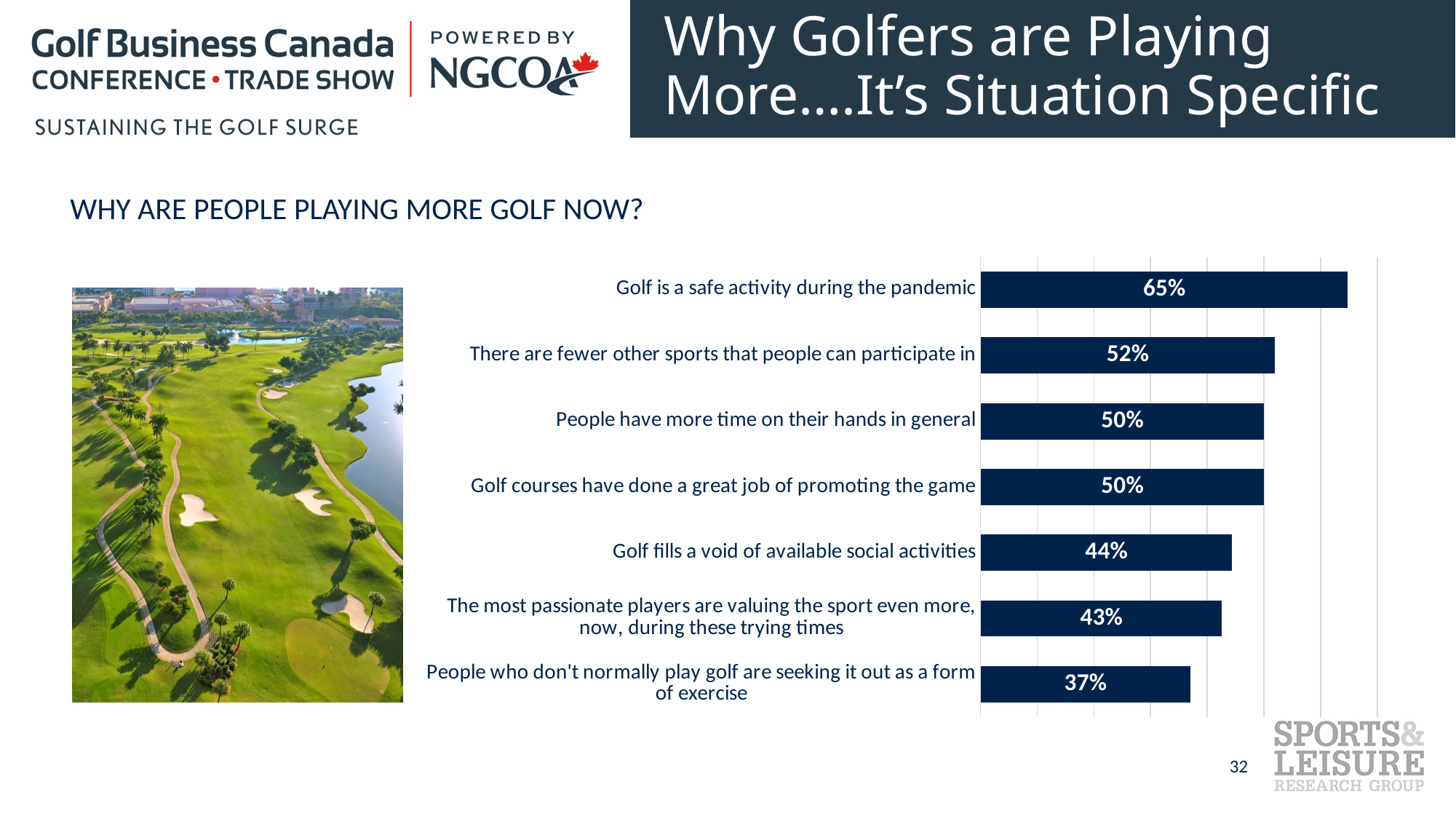
What is the value for 'There are fewer other sports that people can participate in'? 52% What is the difference between the highest and lowest percentages shown? 28% What type of chart is shown on the slide? Bar chart What percentage of respondents said golf is a safe activity during the pandemic? 65% Which reason has the lowest percentage? People who don't normally play golf are seeking it out as a form of exercise How many reasons are listed in the chart? 7 Which reason has the highest percentage? Golf is a safe activity during the pandemic What percentage is shown for 'Golf fills a void of available social activities'? 44% How much higher is 'Golf is a safe activity during the pandemic' than 'There are fewer other sports that people can participate in'? 13% What question does the chart heading ask? WHY ARE PEOPLE PLAYING MORE GOLF NOW? What is the value for 'People who don't normally play golf are seeking it out as a form of exercise'? 37% Which is larger: 'Golf fills a void of available social activities' or 'The most passionate players are valuing the sport even more, now, during these trying times'? Golf fills a void of available social activities